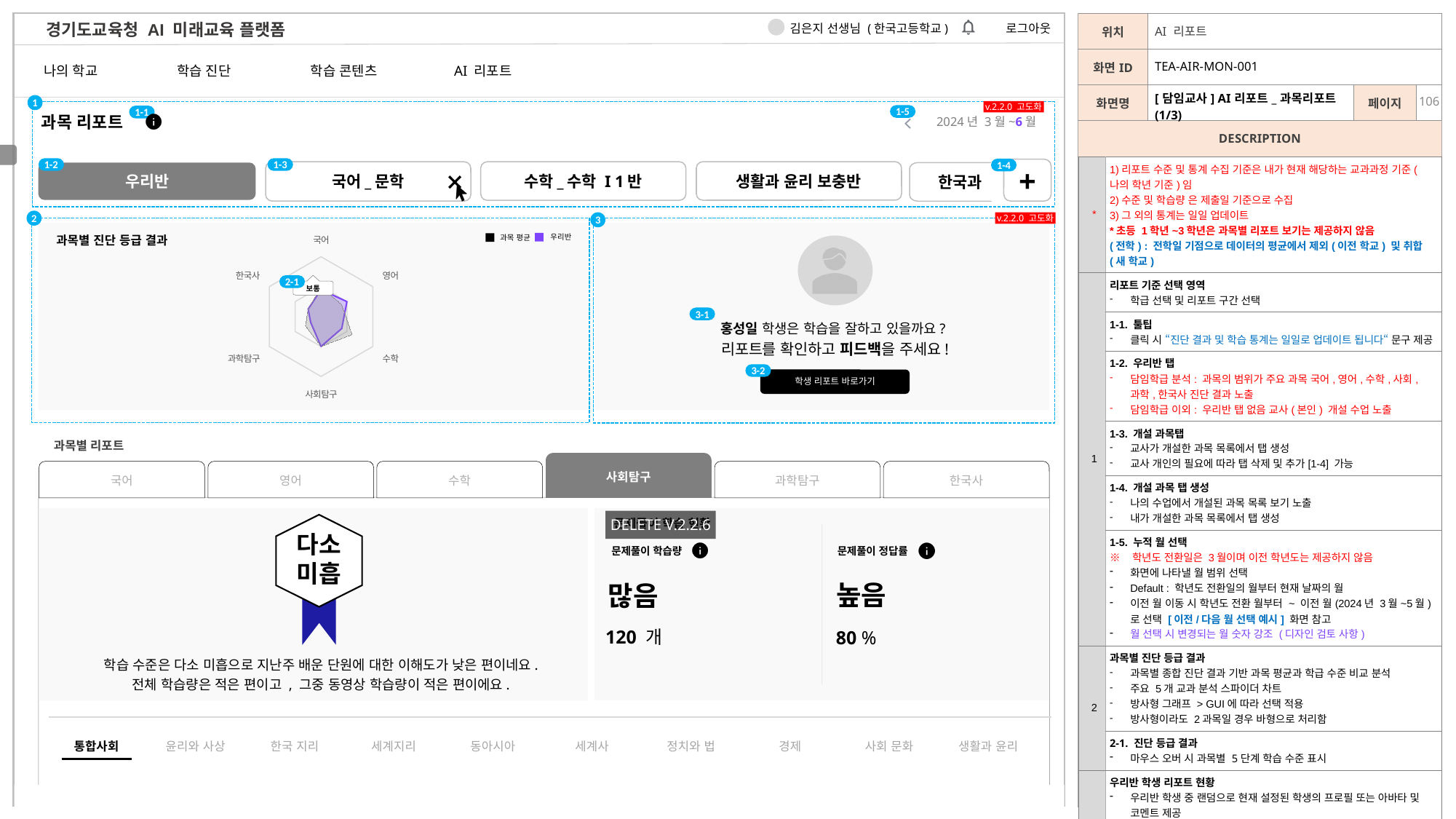
Which subject label sits at the top of the radar chart under 과목별 진단 등급 결과? 국어 What kind of chart is shown under the heading 과목별 진단 등급 결과? radar chart Which legend entry of the radar chart is drawn in purple? 우리반 What are the two legend entries of the radar chart under 과목별 진단 등급 결과? 과목 평균, 우리반 How many subject axes does the radar chart under 과목별 진단 등급 결과 have? 6 How many series does the legend of the radar chart under 과목별 진단 등급 결과 list? 2